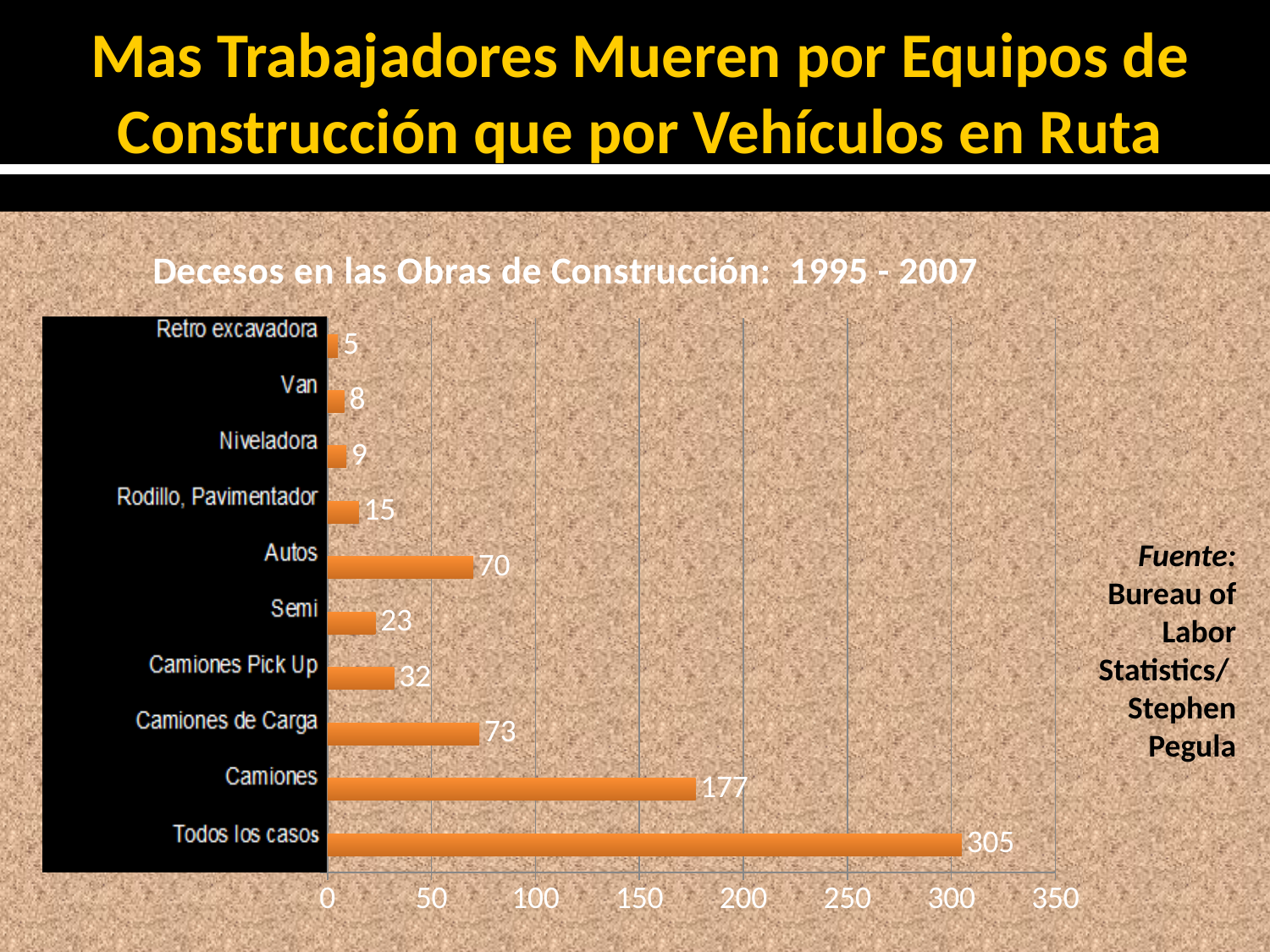
What is the value for Camiones? 177 How many categories are shown in the chart? 10 Which category has the highest value? Todos los casos What is the value for Van? 8 What is the value for Rodillo, Pavimentador? 15 What is the difference between the values for Camiones de Carga and Camiones Pick Up? 41 What is the title of the chart? Decesos en las Obras de Construcción: 1995 - 2007 Which is larger, the value for Semi or the value for Camiones Pick Up? Camiones Pick Up Is the value for Camiones greater or less than 150? greater What kind of chart is shown on the slide? bar chart What is the value for Autos? 70 Which category has the lowest value? Retro excavadora